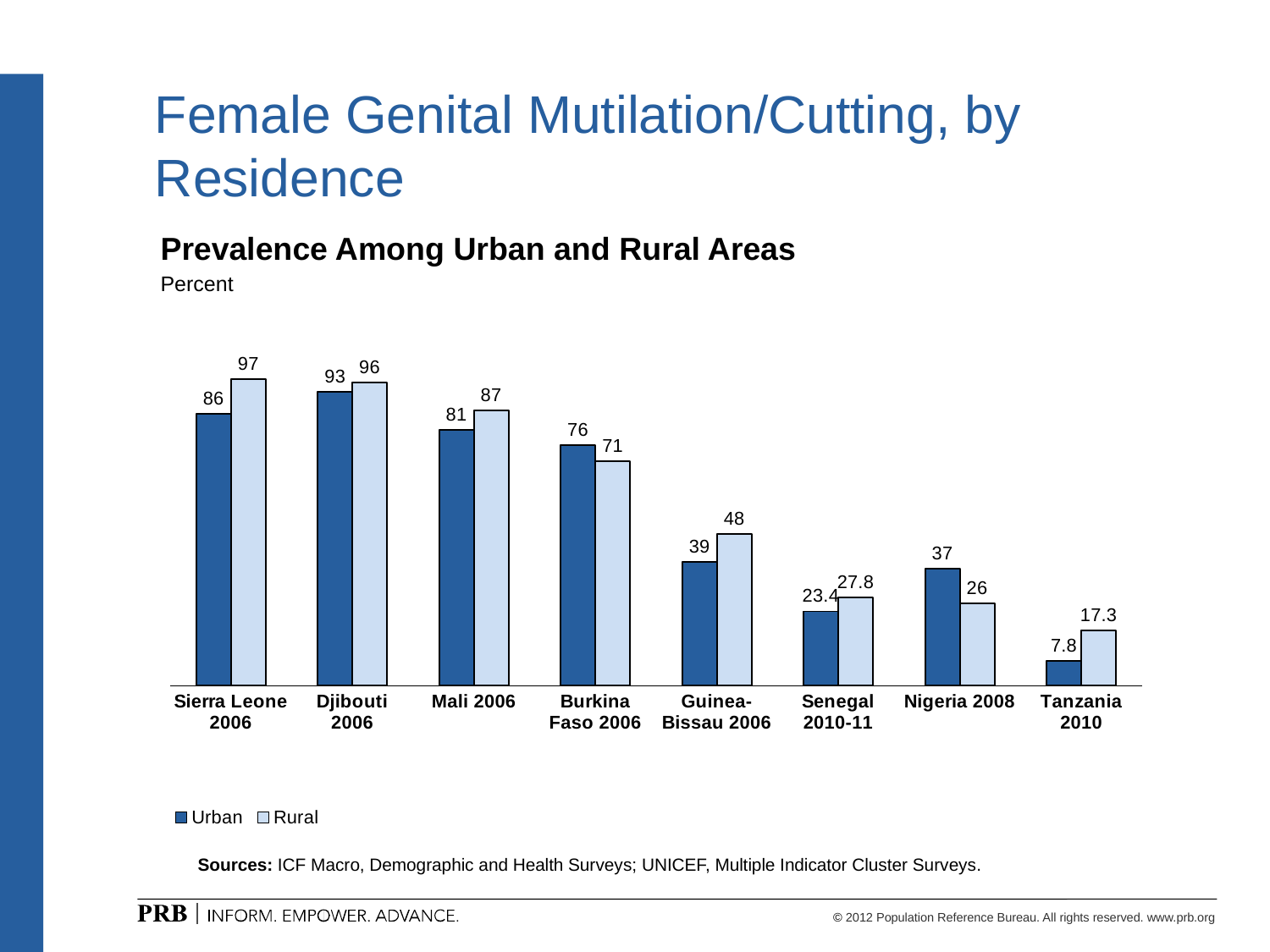
What is the difference between the Rural and Urban values for Guinea-Bissau 2006? 9 Which country has the lowest Urban value? Tanzania 2010 How many countries are shown on the x axis? 8 How many series does the legend list? 2 Which is larger for Burkina Faso 2006, the Urban or the Rural value? Urban What is the Rural value for Senegal 2010-11? 27.8 What is the difference between the Urban and Rural values for Nigeria 2008? 11 What is the Rural value for Tanzania 2010? 17.3 What kind of chart is shown? Bar chart Which country has the highest Rural value? Sierra Leone 2006 What is the Urban value for Sierra Leone 2006? 86 What is the chart's title? Prevalence Among Urban and Rural Areas